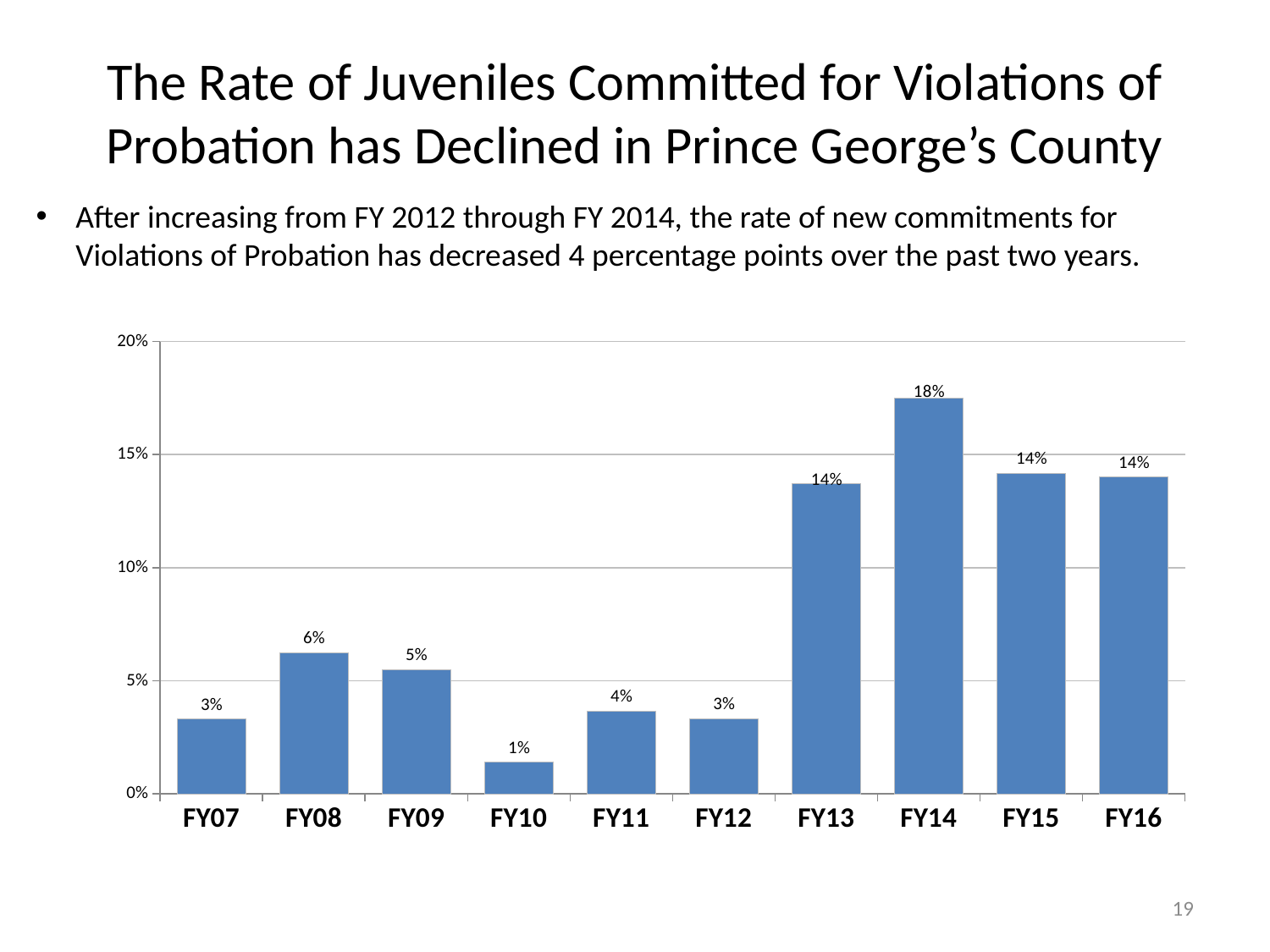
How many fiscal years are shown on the x axis? 10 What is the value for FY14? 18% Is the value for FY13 greater or less than 10%? greater What is the difference between the values for FY14 and FY16? 4% What is the highest value shown on the y axis? 20% What is the value for FY08? 6% Which fiscal year has the highest value? FY14 What is the value for FY10? 1% What kind of chart is shown on the slide? bar chart Which fiscal year has the lowest value? FY10 Which is larger, the value for FY09 or the value for FY11? FY09 Do the values rise or fall from FY12 to FY14? rise